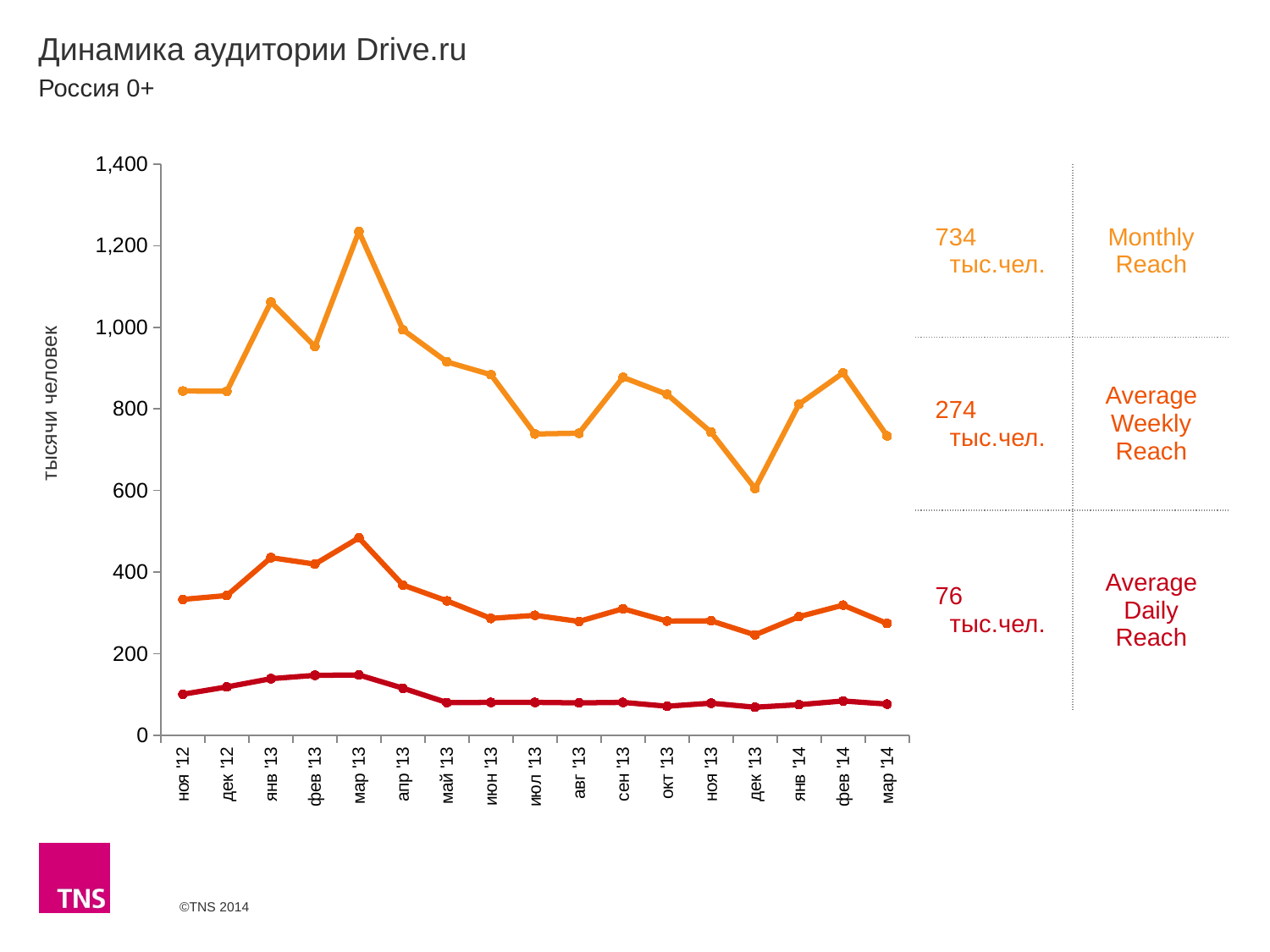
How many months are plotted along the x axis? 17 What is the Average Daily Reach value for мар '14? 76 тыс.чел. In which month is Monthly Reach lowest? дек '13 What is the difference between Monthly Reach and Average Weekly Reach for мар '14? 460 тыс.чел. In which month is Monthly Reach highest? мар '13 Which is larger, Monthly Reach in янв '13 or in фев '13? янв '13 What is the Monthly Reach value for мар '14? 734 тыс.чел. What is the Average Weekly Reach value for мар '14? 274 тыс.чел. What is the label of the y axis? тысячи человек How many series are shown in the chart? 3 What type of chart is shown on the slide? line chart Is the Monthly Reach value for мар '13 greater or less than 1,200? greater